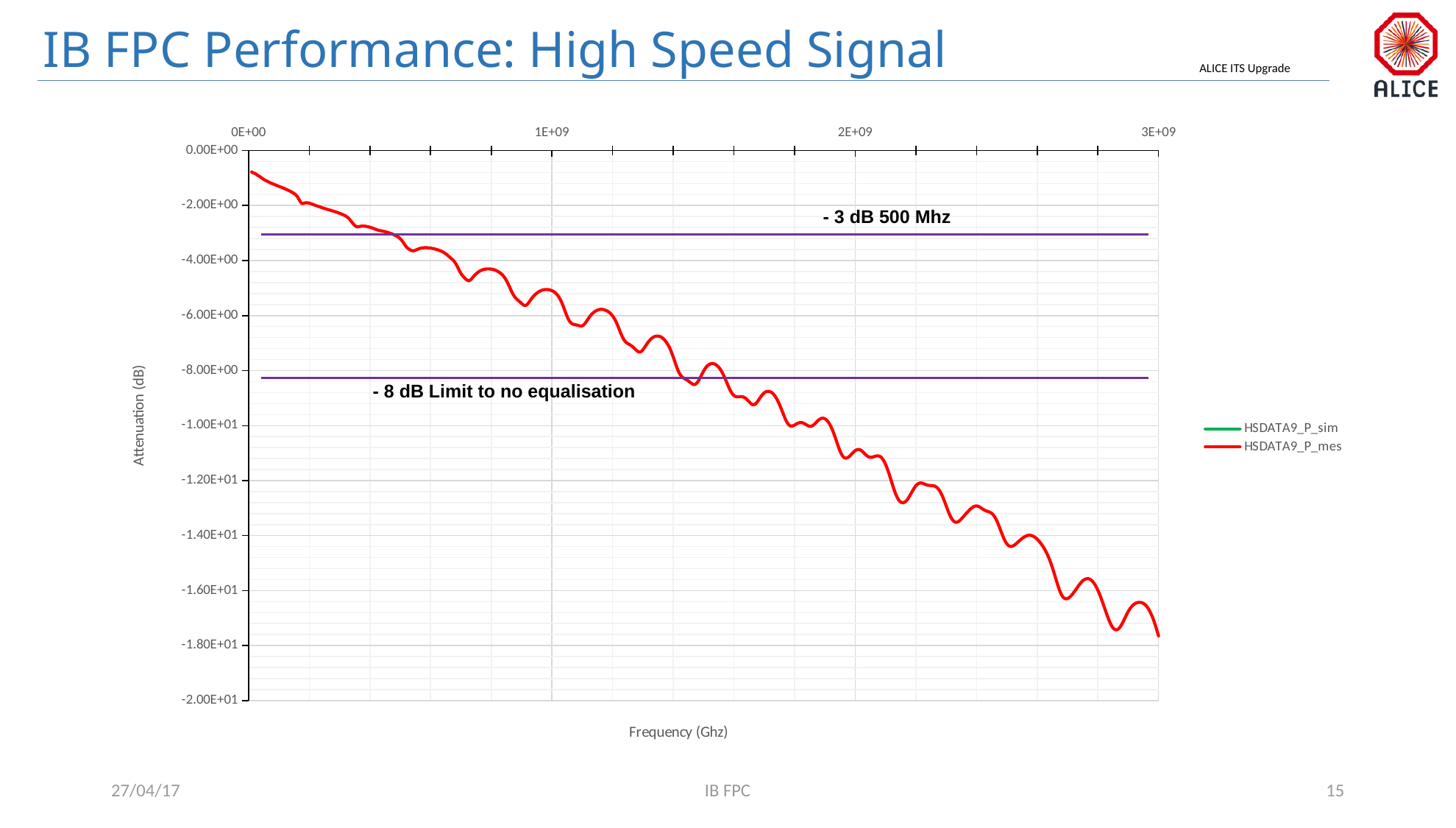
Is the HSDATA9_P_mes value at 0E+00 greater or less than -2.00E+00? greater Which series is drawn in red according to the legend? HSDATA9_P_mes Is the HSDATA9_P_mes value at 1E+09 greater or less than -4.00E+00? less Does the HSDATA9_P_mes line rise or fall as frequency increases along the x axis? fall Is the HSDATA9_P_mes value at 2E+09 greater or less than -1.00E+01? less What kind of chart is shown on the slide? line chart Is the HSDATA9_P_mes value at 1E+09 larger or smaller than its value at 2E+09? larger What is the highest frequency tick shown on the x axis? 3E+09 What is the label of the y axis? Attenuation (dB) How many series does the legend list? 2